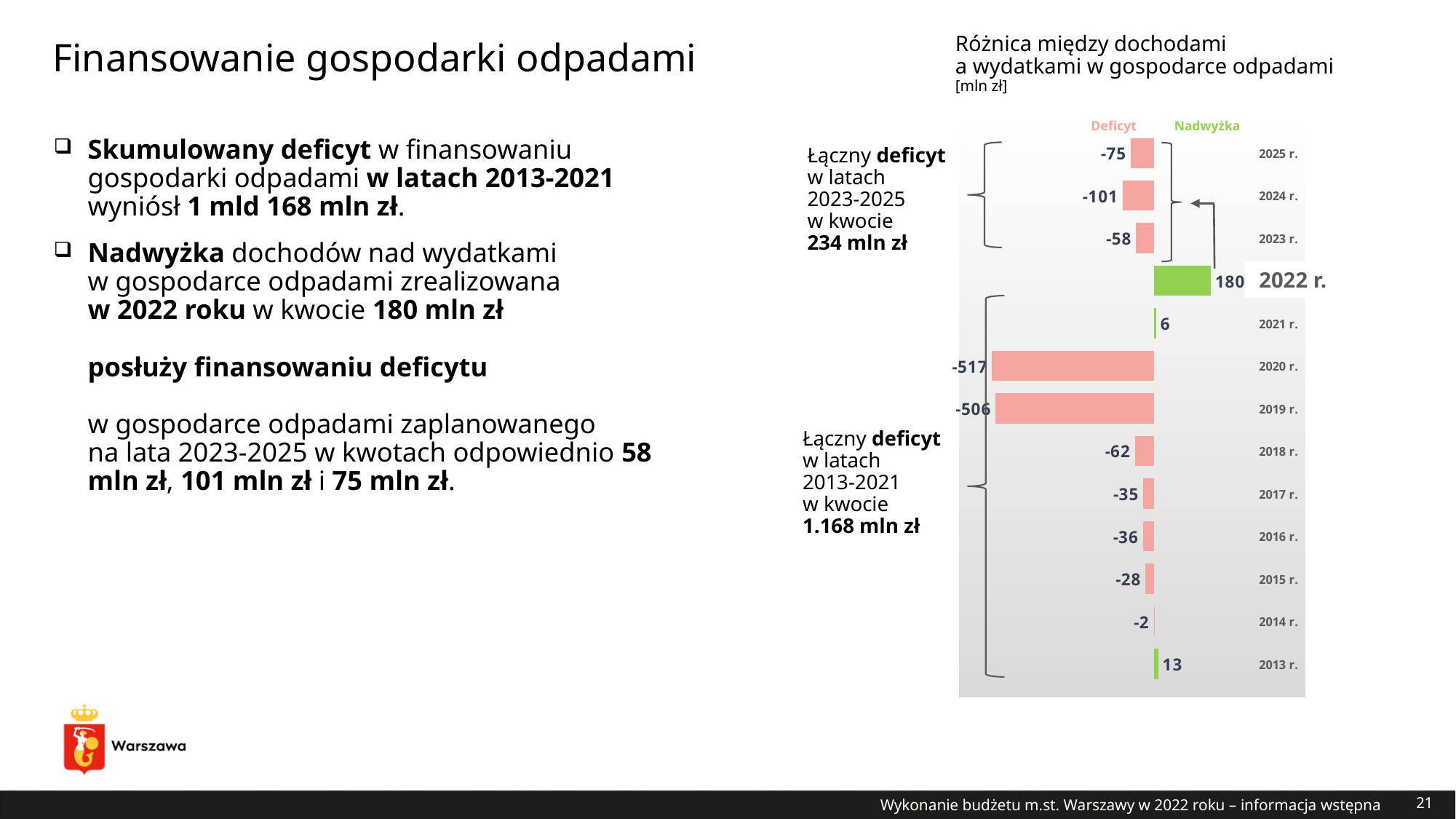
What type of chart is shown on the slide? Bar chart Which year has the lowest value in the chart? 2020 r. What is the difference between the values for 2024 r. and 2025 r.? 26 What is the value shown for 2022 r. in the chart? 180 How many categories does the chart legend list? 2 What is the value shown for 2024 r. in the chart? -101 Which is larger, the value for 2021 r. or the value for 2013 r.? 2013 r. What is the value shown for 2013 r. in the chart? 13 How many years are shown in the chart? 13 What is the value shown for 2020 r. in the chart? -517 Which year has the highest value in the chart? 2022 r. What is the difference between the values for 2020 r. and 2019 r.? 11